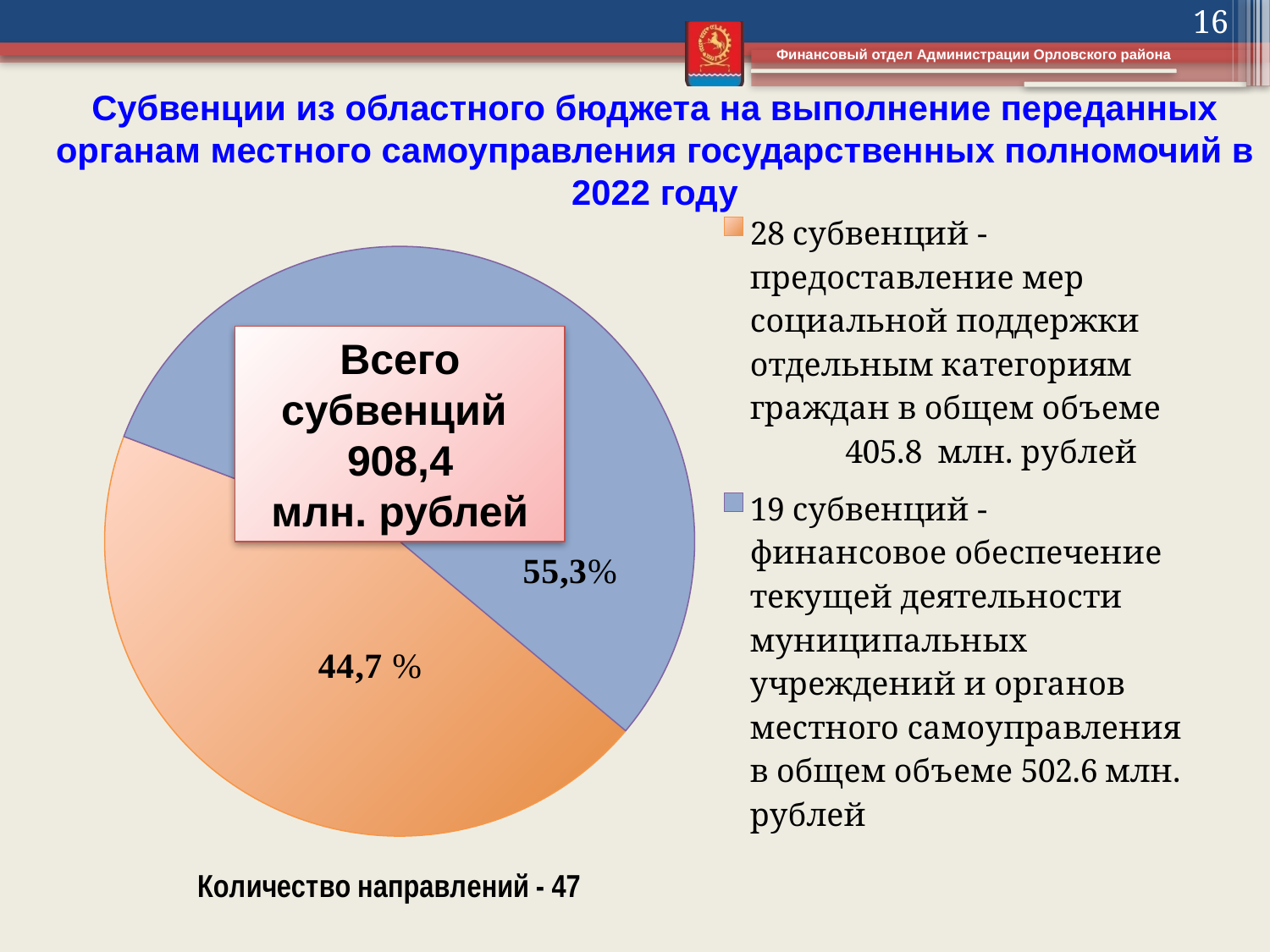
What is the total amount of subventions shown in the centre of the pie chart? 908,4 млн. рублей Which group has the larger total volume: the 28 subventions for social support or the 19 subventions for financial support of municipal institutions? The 19 subventions for financial support of municipal institutions What kind of chart is shown on the slide? Pie chart What share of the pie does the blue slice (financial support of municipal institutions) represent? 55,3% How many slices does the pie chart have? 2 What is the total volume of the 28 subventions for social support of certain categories of citizens? 405.8 млн. рублей What is the difference in percentage points between the blue slice (55,3%) and the orange slice (44,7 %)? 10,6 percentage points Which slice of the pie is larger: the orange one (social support) or the blue one (financial support of municipal institutions)? The blue one (financial support of municipal institutions) By how much does the volume of the 19 subventions (502.6) exceed the volume of the 28 subventions (405.8), in млн. рублей? 96.8 млн. рублей What share of the pie does the orange slice (social support subventions) represent? 44,7 % According to the caption below the pie chart, how many directions (направлений) are there? 47 What is the total volume of the 19 subventions for financial support of municipal institutions and local self-government bodies? 502.6 млн. рублей